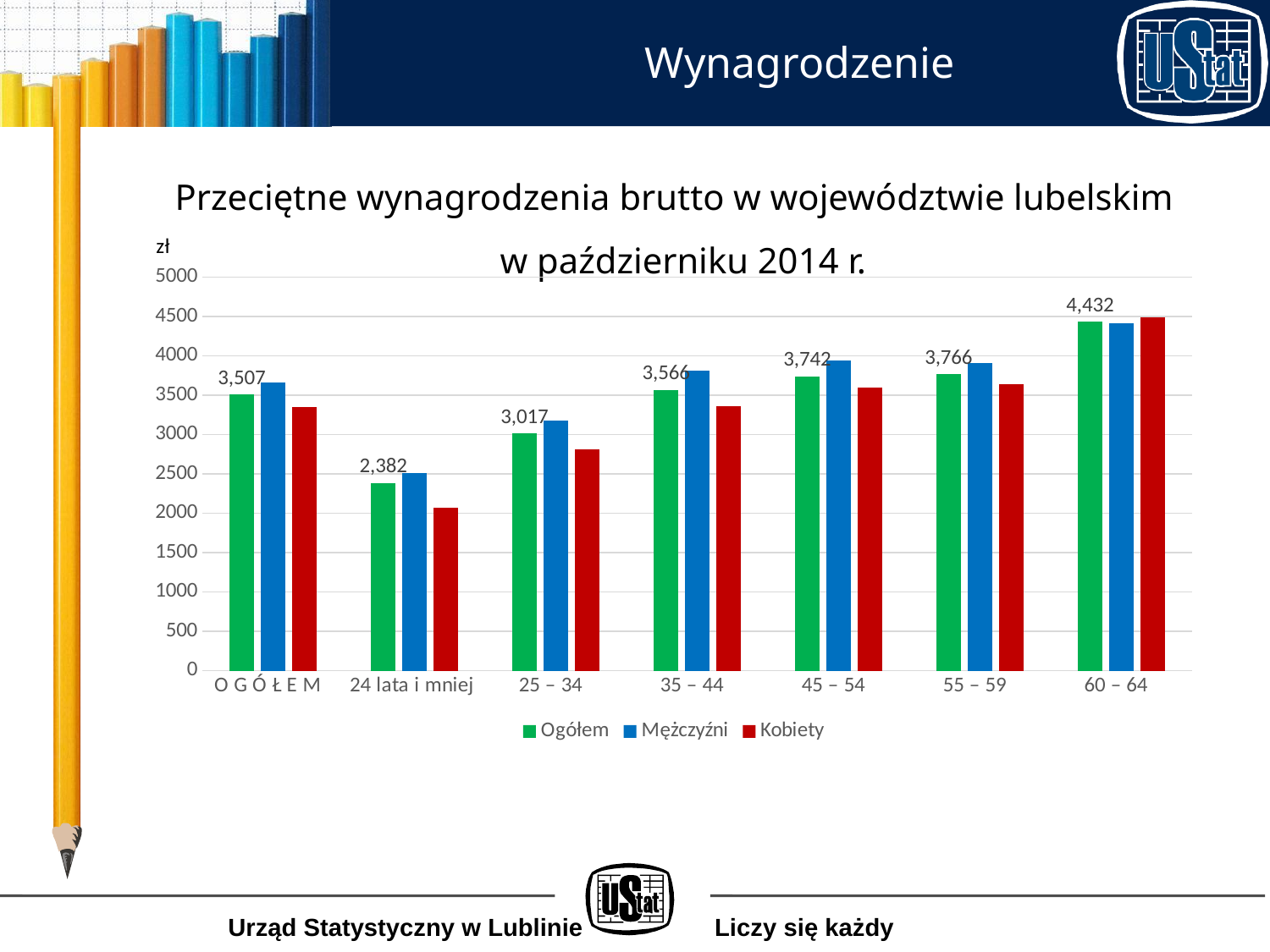
What kind of chart is shown on the slide? bar chart Is the Mężczyźni value for 60 – 64 greater or less than 4000? greater What is the Ogółem value for the 24 lata i mniej category? 2,382 Is the Kobiety value for 24 lata i mniej greater or less than 2500? less How many categories are shown on the x axis? 7 What is the Ogółem value for the 60 – 64 age group? 4,432 Which age category has the highest Ogółem value? 60 – 64 Which age category has the lowest Ogółem value? 24 lata i mniej What is the Ogółem value for the 35 – 44 age group? 3,566 What is the difference between the Ogółem values for 60 – 64 and 24 lata i mniej? 2,050 Which is larger, the Ogółem value for 45 – 54 or for 25 – 34? 45 – 54 How many series does the legend list? 3